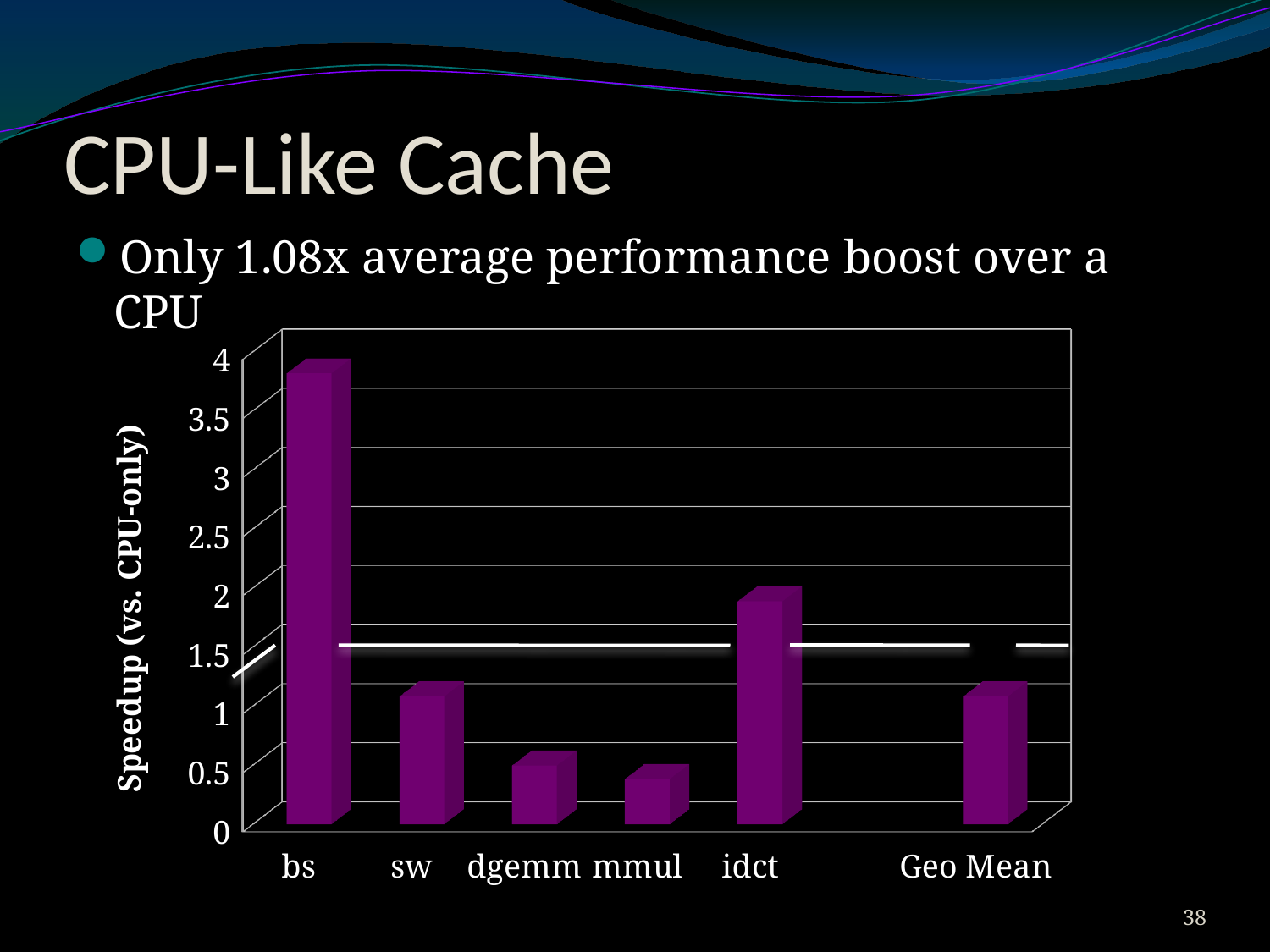
Which has the larger speedup, sw or mmul? sw Is the speedup for Geo Mean greater or less than 2? less Is the speedup for mmul greater or less than 1? less Which has the larger speedup, bs or idct? bs Which category has the highest speedup in the chart? bs Is the speedup for dgemm greater or less than 1? less What is the title of the vertical axis of the chart? Speedup (vs. CPU-only) What kind of chart is shown on the slide? bar chart How many categories are plotted on the x axis of the chart? 6 Which has the larger speedup, idct or sw? idct